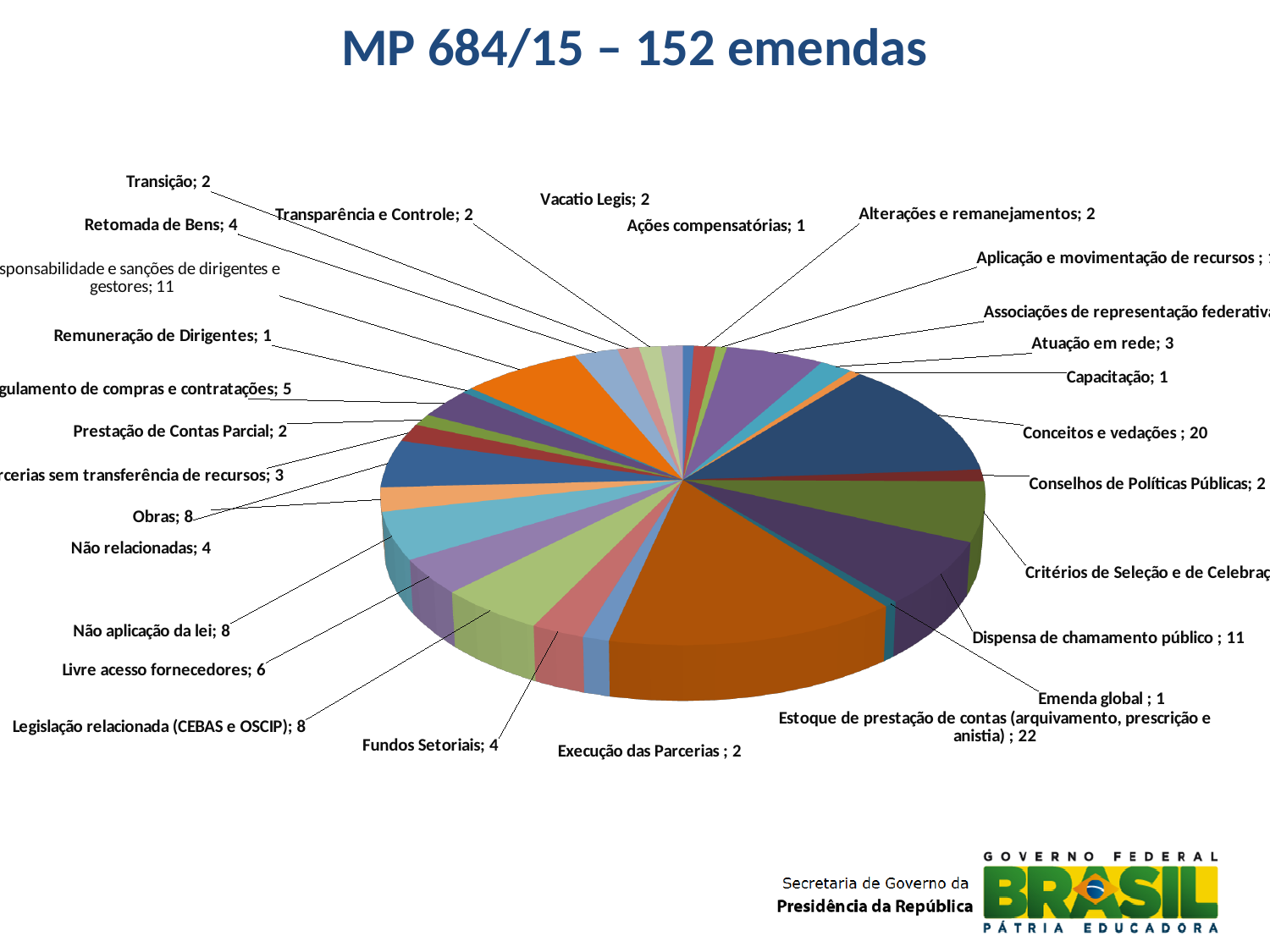
What is the value for "Dispensa de chamamento público"? 11 What is the difference between the values for "Estoque de prestação de contas" and "Conceitos e vedações"? 2 Which has a larger value, "Retomada de Bens" or "Não aplicação da lei"? Não aplicação da lei What is the title of the chart? MP 684/15 – 152 emendas How many emendas are shown for "Estoque de prestação de contas (arquivamento, prescrição e anistia)"? 22 What is the value for "Regulamento de compras e contratações"? 5 What is the value for "Livre acesso fornecedores"? 6 What is the value for "Fundos Setoriais"? 4 What kind of chart is shown on the slide? Pie chart What is the difference between the values for "Obras" and "Não relacionadas"? 4 What is the value for "Conceitos e vedações"? 20 Which has a larger value, "Dispensa de chamamento público" or "Atuação em rede"? Dispensa de chamamento público